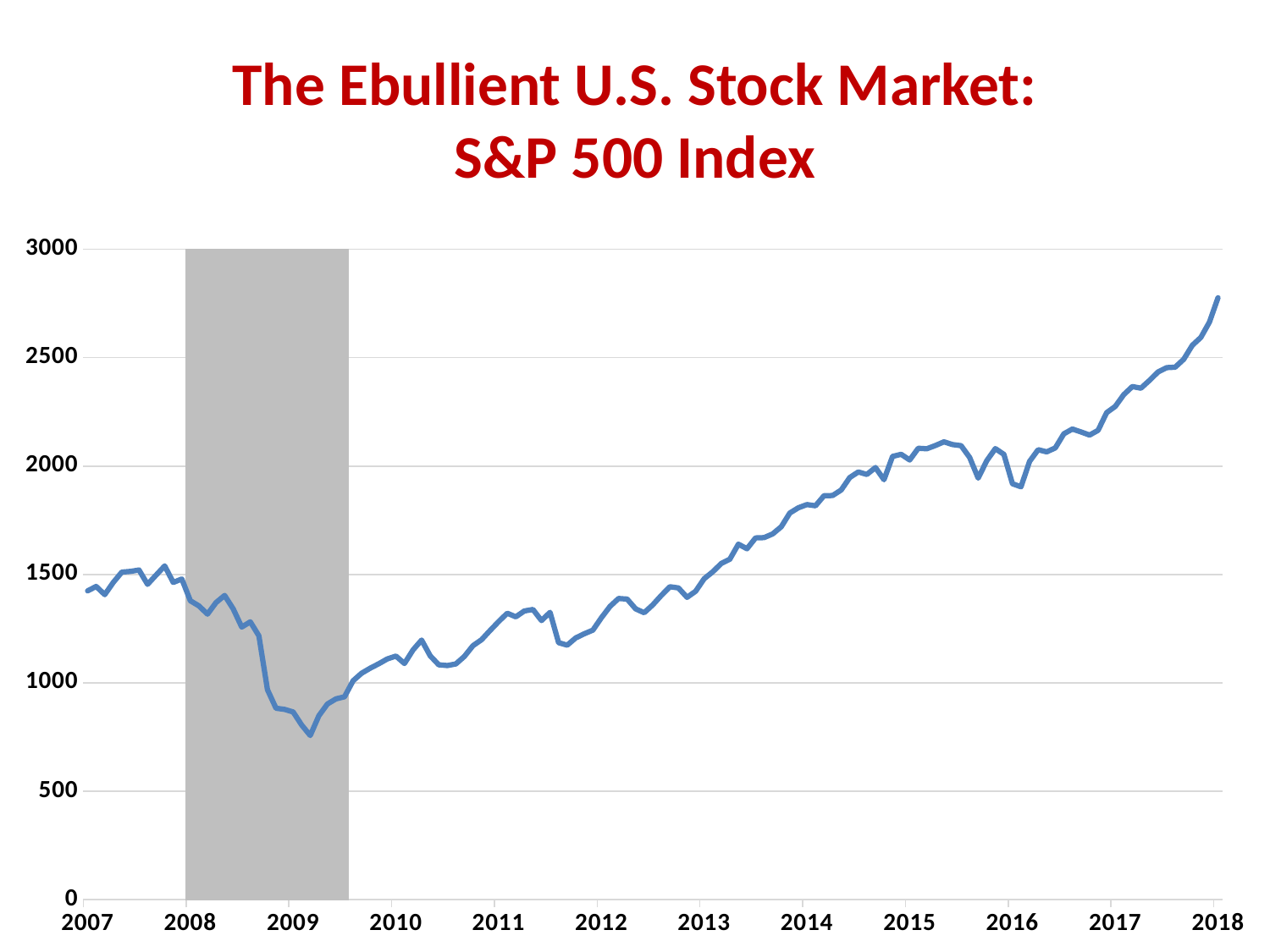
What is the title of the chart? The Ebullient U.S. Stock Market: S&P 500 Index Does the S&P 500 Index generally rise or fall between 2009 and 2018? rise Is the value of the S&P 500 Index at 2017 greater or less than 2000? greater How many year labels are shown on the x axis? 12 Is the value of the S&P 500 Index at 2012 greater or less than 1500? less Is the value of the S&P 500 Index at 2018 greater or less than 2500? greater What kind of chart is shown on the slide? line chart At which year label does the S&P 500 Index reach its highest value on the chart? 2018 In which year does the S&P 500 Index reach its lowest point on the chart? 2009